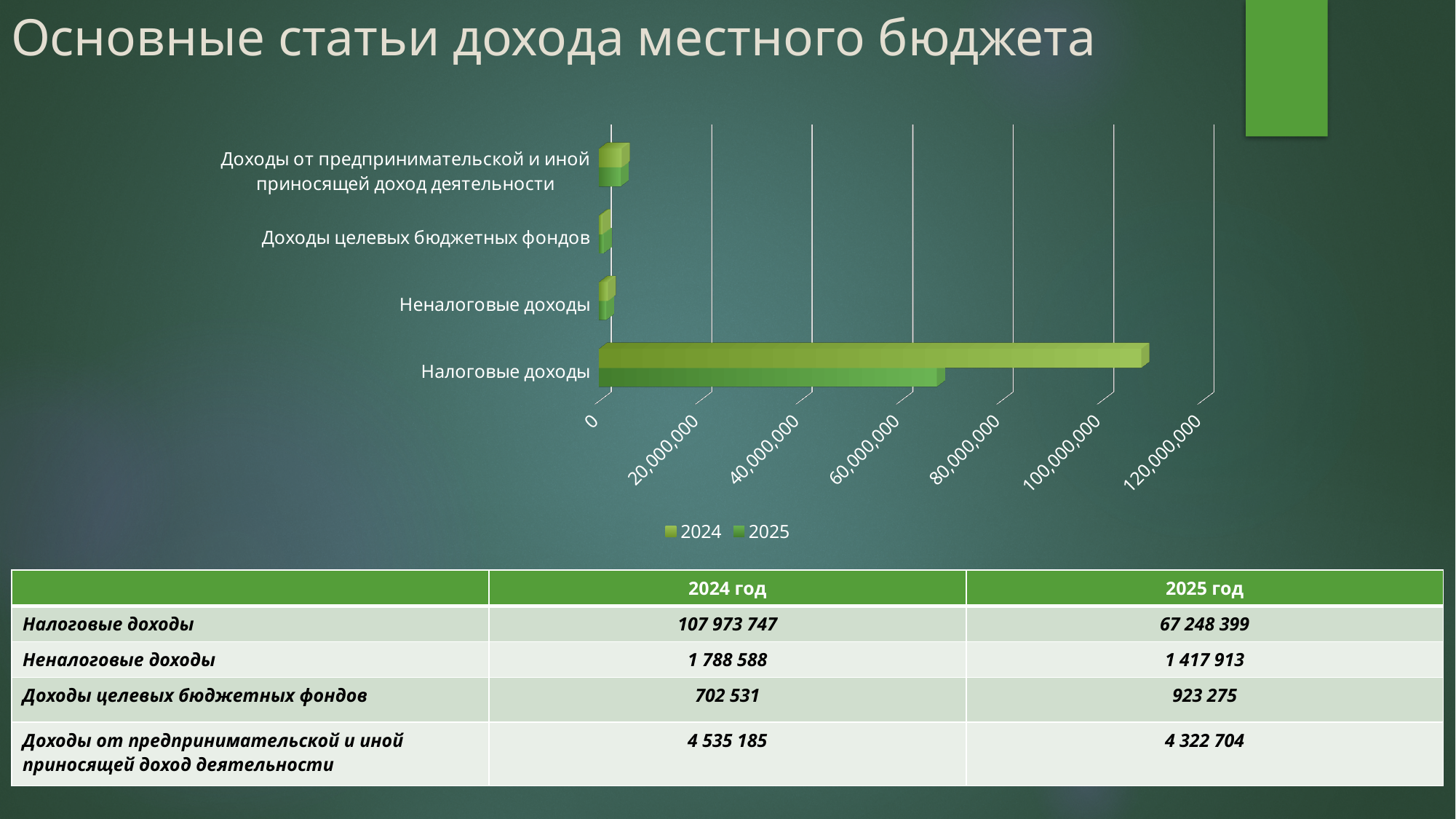
Is the 2024 value for Налоговые доходы greater or less than 100,000,000? greater Which is larger for Налоговые доходы: the 2024 value or the 2025 value? 2024 Which category has the lowest value for 2024? Доходы целевых бюджетных фондов What is the value of Налоговые доходы for 2024? 107 973 747 What is the difference between the 2024 and 2025 values for Налоговые доходы? 40 725 348 How many categories does the chart show? 4 How many series does the chart legend list? 2 What kind of chart is shown on the slide? bar chart Which series are listed in the chart legend? 2024 and 2025 What is the value of Доходы целевых бюджетных фондов for 2025? 923 275 What is the value of Налоговые доходы for 2025? 67 248 399 Which category has the highest value in the chart? Налоговые доходы